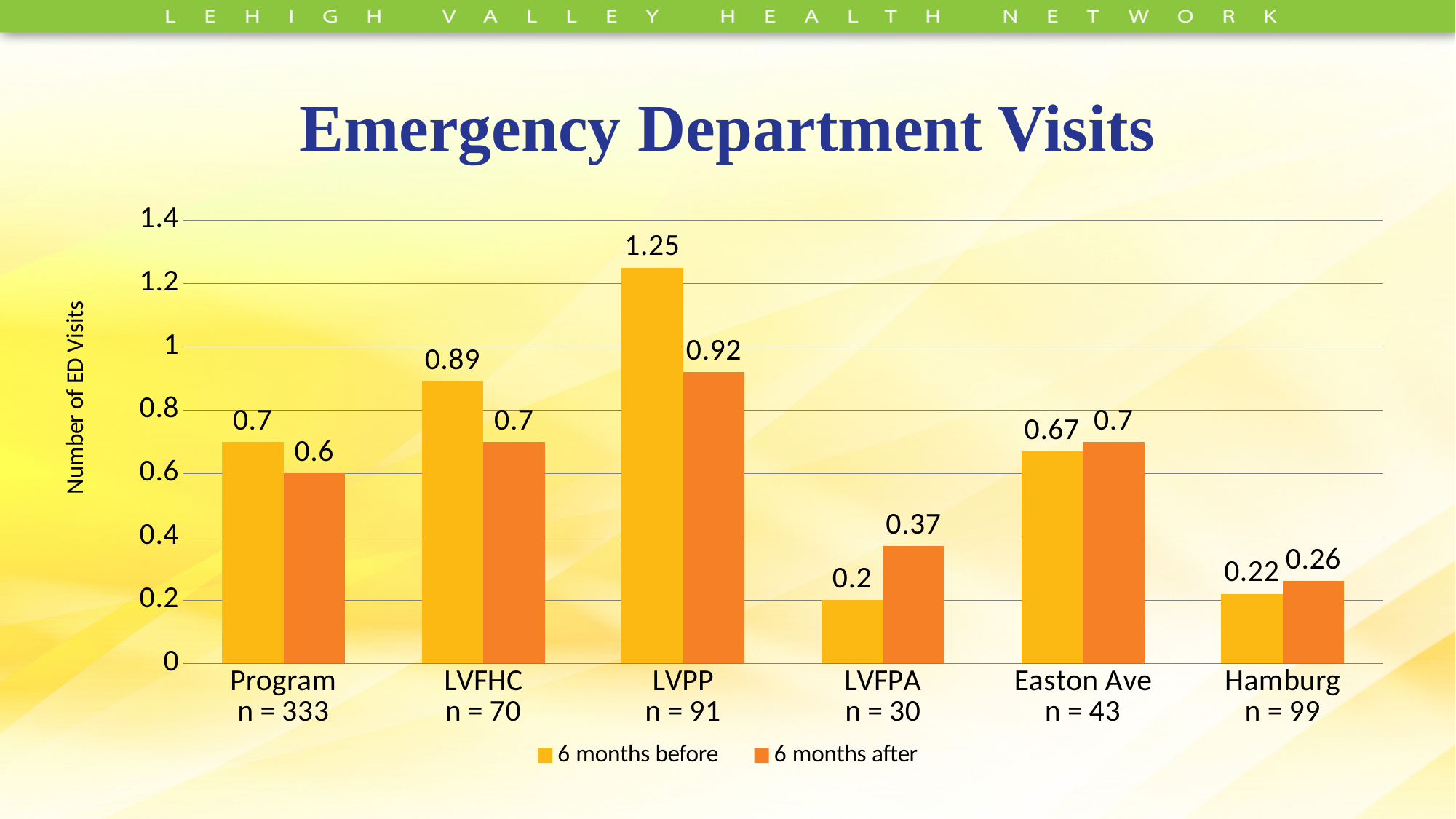
What is the value for Easton Ave in the 6 months before series? 0.67 What is the value for LVFPA in the 6 months after series? 0.37 For LVFPA, which is larger: the 6 months before value or the 6 months after value? 6 months after What is the value for LVPP in the 6 months before series? 1.25 How many series does the legend list? 2 What is the difference between the 6 months before and 6 months after values for LVFHC? 0.19 Which category has the lowest value in the 6 months after series? Hamburg Which category has the highest value in the 6 months before series? LVPP What is the label of the vertical axis? Number of ED Visits How many categories are shown on the x axis? 6 What kind of chart is shown on the slide? Bar chart What is the difference between the 6 months before and 6 months after values for LVPP? 0.33